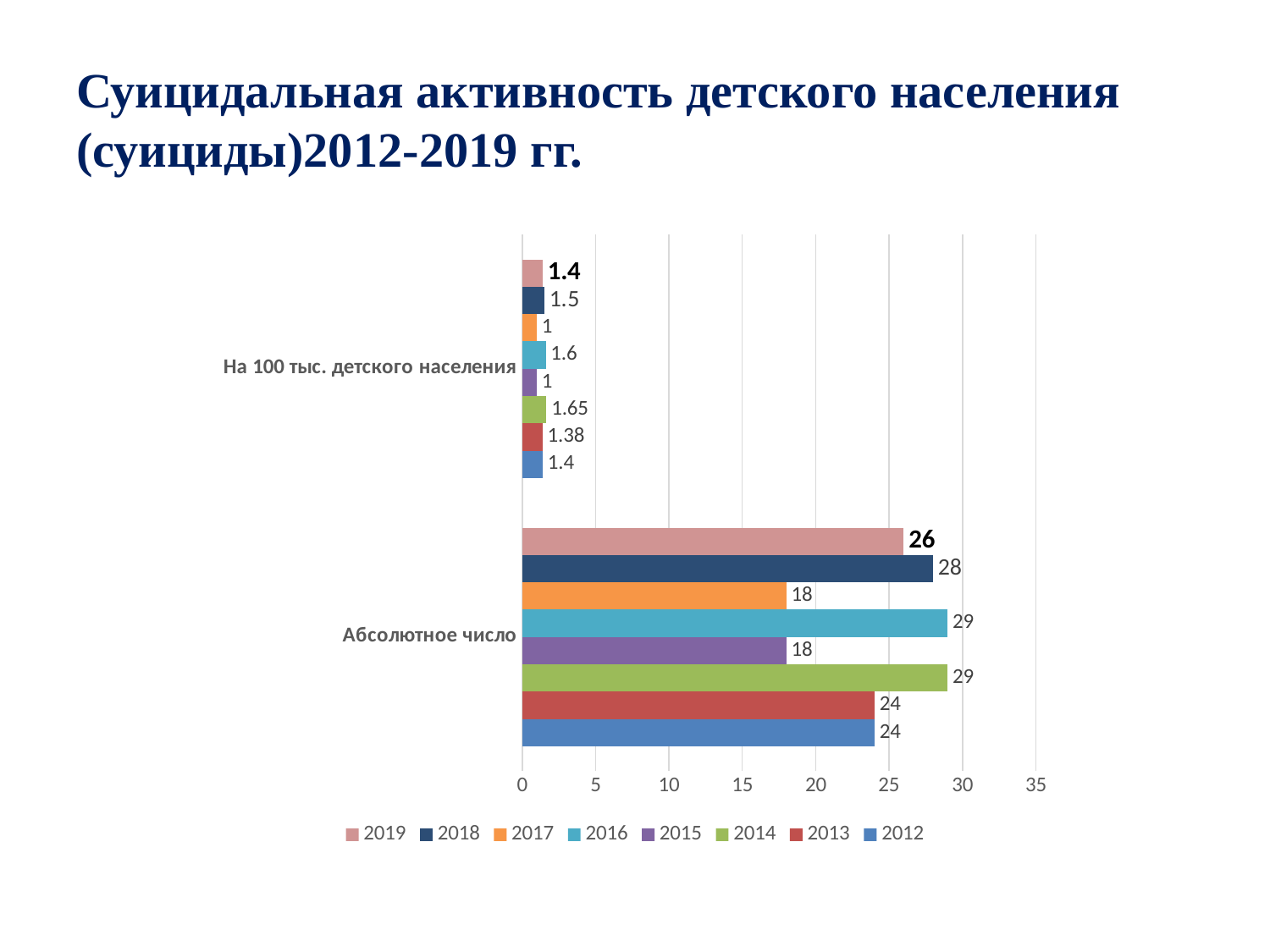
What is the difference between the 2016 and 2019 values in the "Абсолютное число" category? 3 What is the difference between the 2018 and 2017 values in the "Абсолютное число" category? 10 Which year has the highest value in the "На 100 тыс. детского населения" category? 2014 What kind of chart is shown on the slide? Bar chart What is the value for 2013 in the "На 100 тыс. детского населения" category? 1.38 What is the value for 2019 in the "Абсолютное число" category? 26 How many series does the legend list? 8 How many categories are shown on the vertical axis? 2 What is the value for 2018 in the "Абсолютное число" category? 28 What is the value for 2014 in the "На 100 тыс. детского населения" category? 1.65 In the "На 100 тыс. детского населения" category, which is larger: the value for 2016 or the value for 2017? 2016 In the "Абсолютное число" category, which is larger: the value for 2019 or the value for 2013? 2019